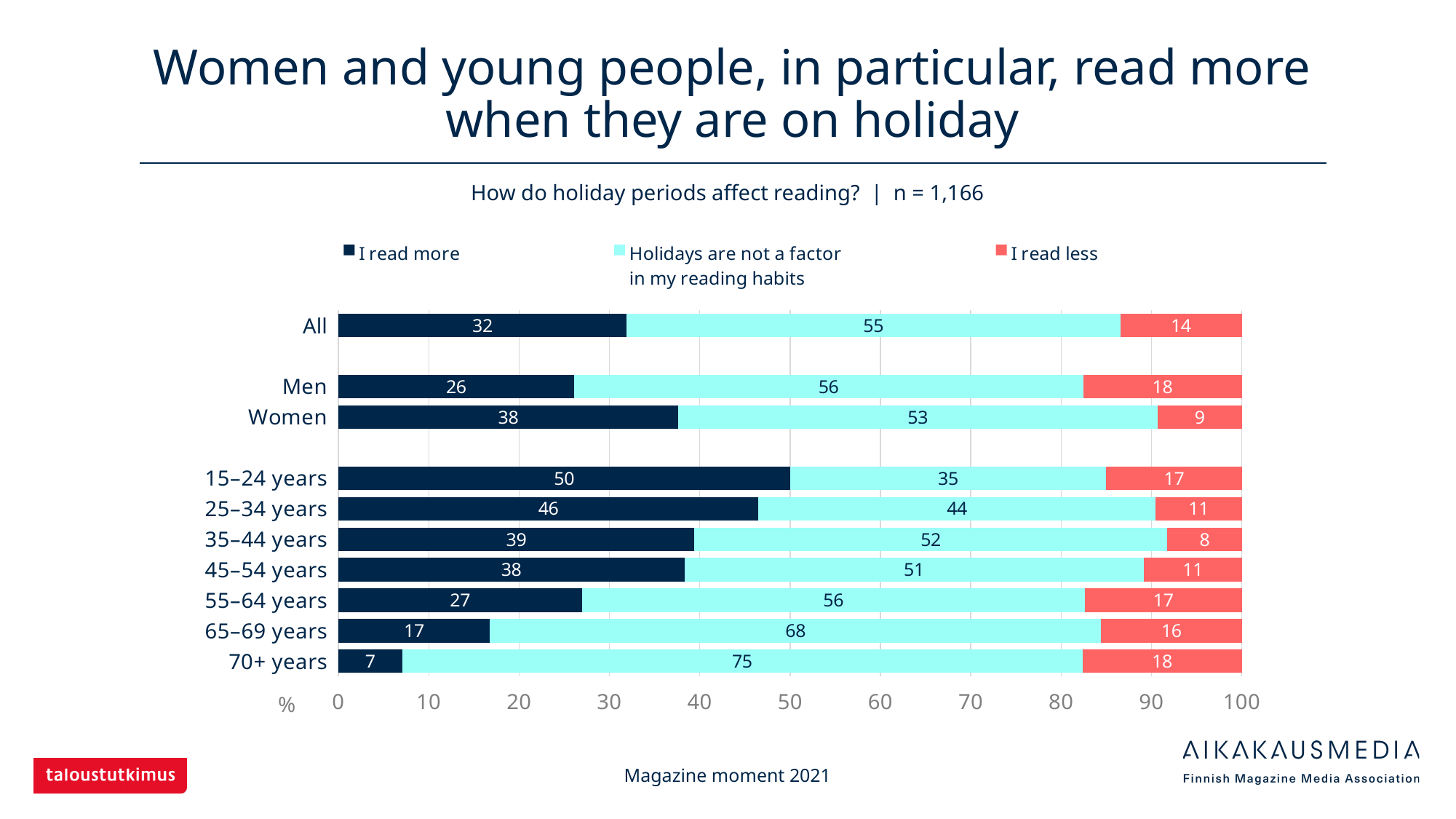
What is the total of the stacked bar for 25–34 years? 101 What percentage of all respondents say they read more on holiday? 32 How many categories are shown on the y axis? 10 What is the 'Holidays are not a factor in my reading habits' value for the 70+ years group? 75 What is the sample size (n) stated in the chart subtitle? 1,166 What is the 'I read less' value for Women? 9 Which has a larger 'I read less' value, Men or Women? Men What is the difference between the 'I read more' values for Women and Men? 12 Which age group has the highest 'I read more' value? 15–24 years What kind of chart is shown on the slide? Stacked bar chart Which category has the lowest 'I read more' value? 70+ years How many series does the legend list? 3